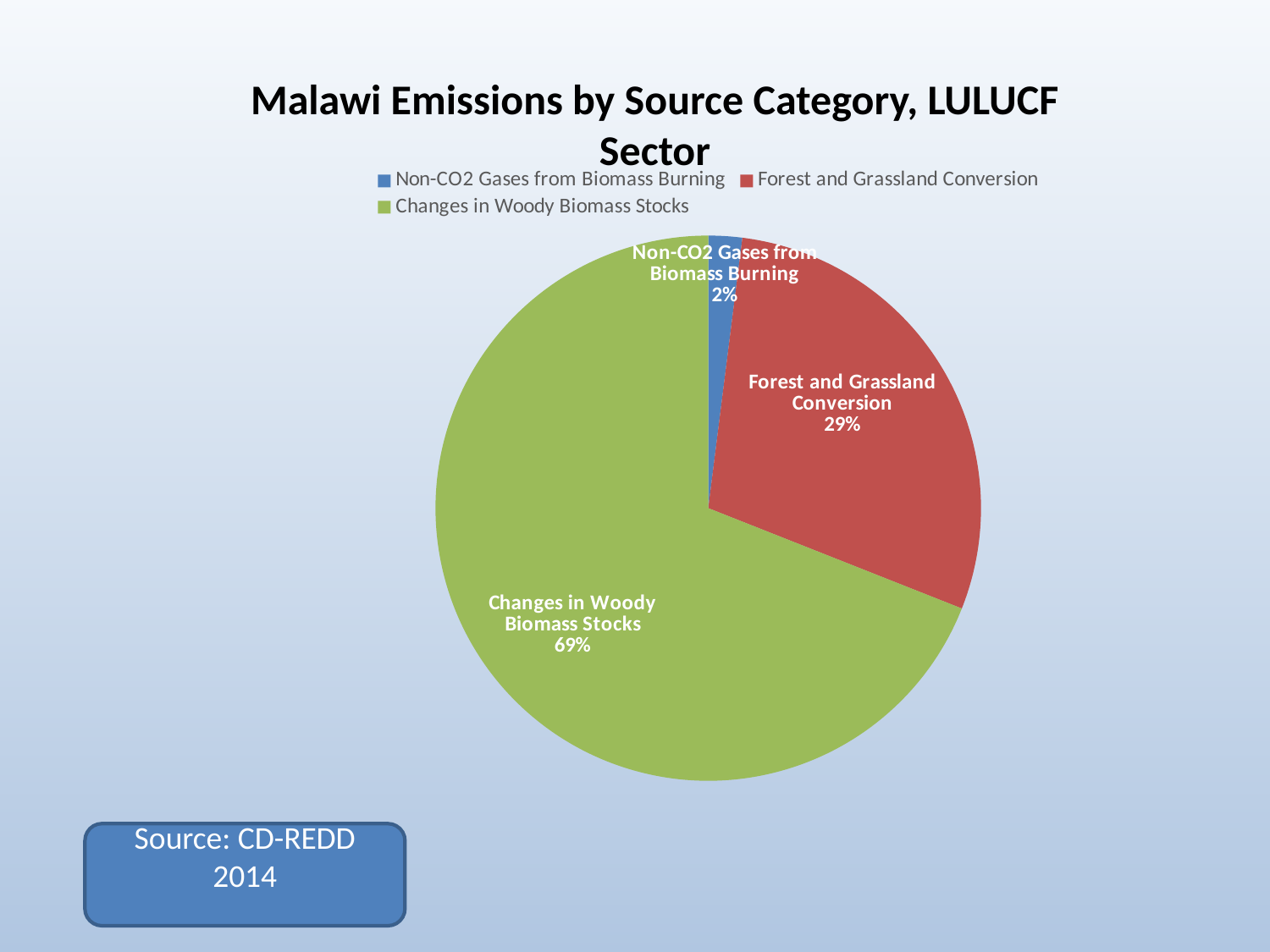
What share of emissions comes from Non-CO2 Gases from Biomass Burning? 2% What colour is the slice for Forest and Grassland Conversion? Red What share of emissions comes from Forest and Grassland Conversion? 29% What is the title of the chart? Malawi Emissions by Source Category, LULUCF Sector What is the difference in percentage points between Changes in Woody Biomass Stocks and Forest and Grassland Conversion? 40 percentage points How many source categories are shown in the pie chart? 3 How many entries does the legend list? 3 Which source category has the largest share of emissions? Changes in Woody Biomass Stocks What share of emissions comes from Changes in Woody Biomass Stocks? 69% Which source category has the smallest share of emissions? Non-CO2 Gases from Biomass Burning Which is larger: the share for Forest and Grassland Conversion or the share for Non-CO2 Gases from Biomass Burning? Forest and Grassland Conversion What kind of chart is shown on the slide? Pie chart